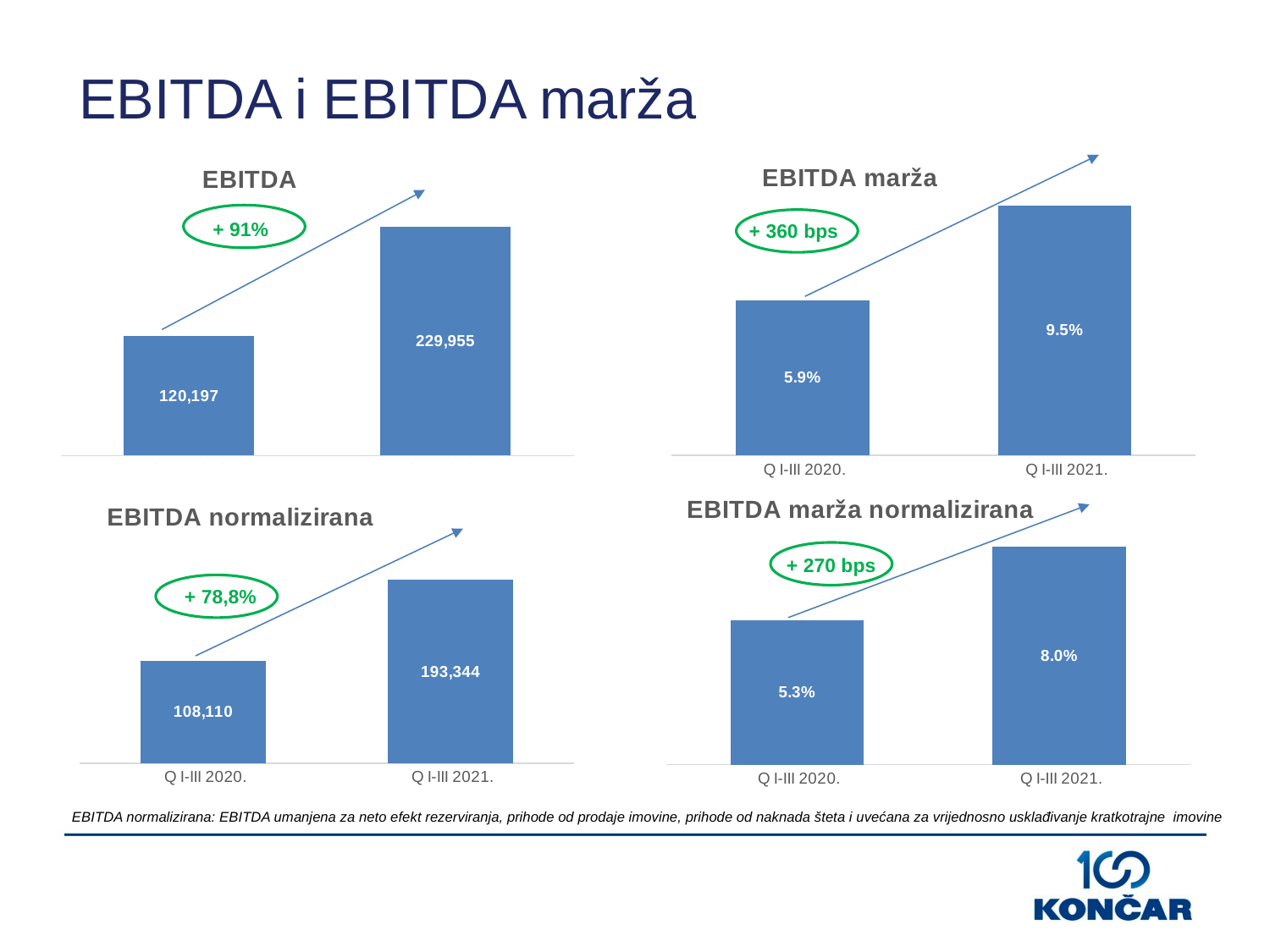
What type of chart is the 'EBITDA normalizirana' chart? Bar chart In the 'EBITDA normalizirana' chart, what is the difference between the Q I-III 2021. and Q I-III 2020. values? 85,234 How many bars are in the 'EBITDA marža' chart? 2 In the 'EBITDA' chart, what is the value of the right bar? 229,955 In the 'EBITDA marža' chart, what is the value for Q I-III 2020.? 5.9% In the 'EBITDA marža normalizirana' chart, which period has the higher value? Q I-III 2021. In the 'EBITDA normalizirana' chart, what is the value for Q I-III 2020.? 108,110 In the 'EBITDA' chart, what is the value of the left bar? 120,197 In the 'EBITDA marža' chart, what is the value for Q I-III 2021.? 9.5% What percentage change is shown in the green oval on the 'EBITDA normalizirana' chart? + 78,8% In the 'EBITDA marža normalizirana' chart, what is the value for Q I-III 2021.? 8.0% In the 'EBITDA' chart, what is the difference between the right bar and the left bar? 109,758